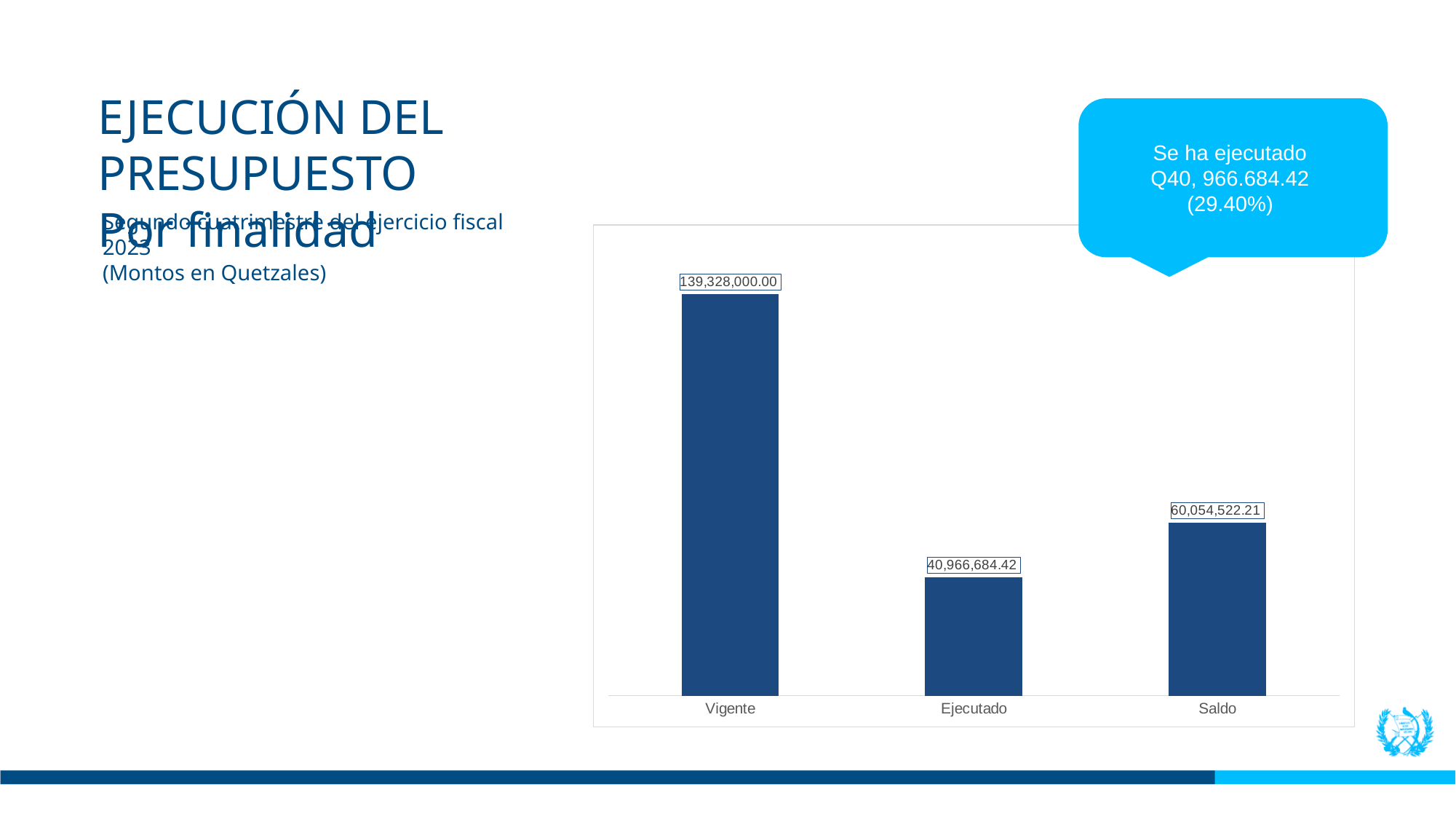
What is the value for Vigente? 139,328,000.00 Which is larger, the value for Saldo or the value for Ejecutado? Saldo What kind of chart is shown on the slide? Bar chart What is the difference between the values for Vigente and Ejecutado? 98,361,315.58 Which category has the lowest value? Ejecutado Which category has the highest value? Vigente What is the value for Ejecutado? 40,966,684.42 What is the value for Saldo? 60,054,522.21 How many categories are shown in the chart? 3 What percentage of execution is stated in the callout on the slide? 29.40% What colour are the bars in the chart? Dark blue What is the difference between the values for Saldo and Ejecutado? 19,087,837.79